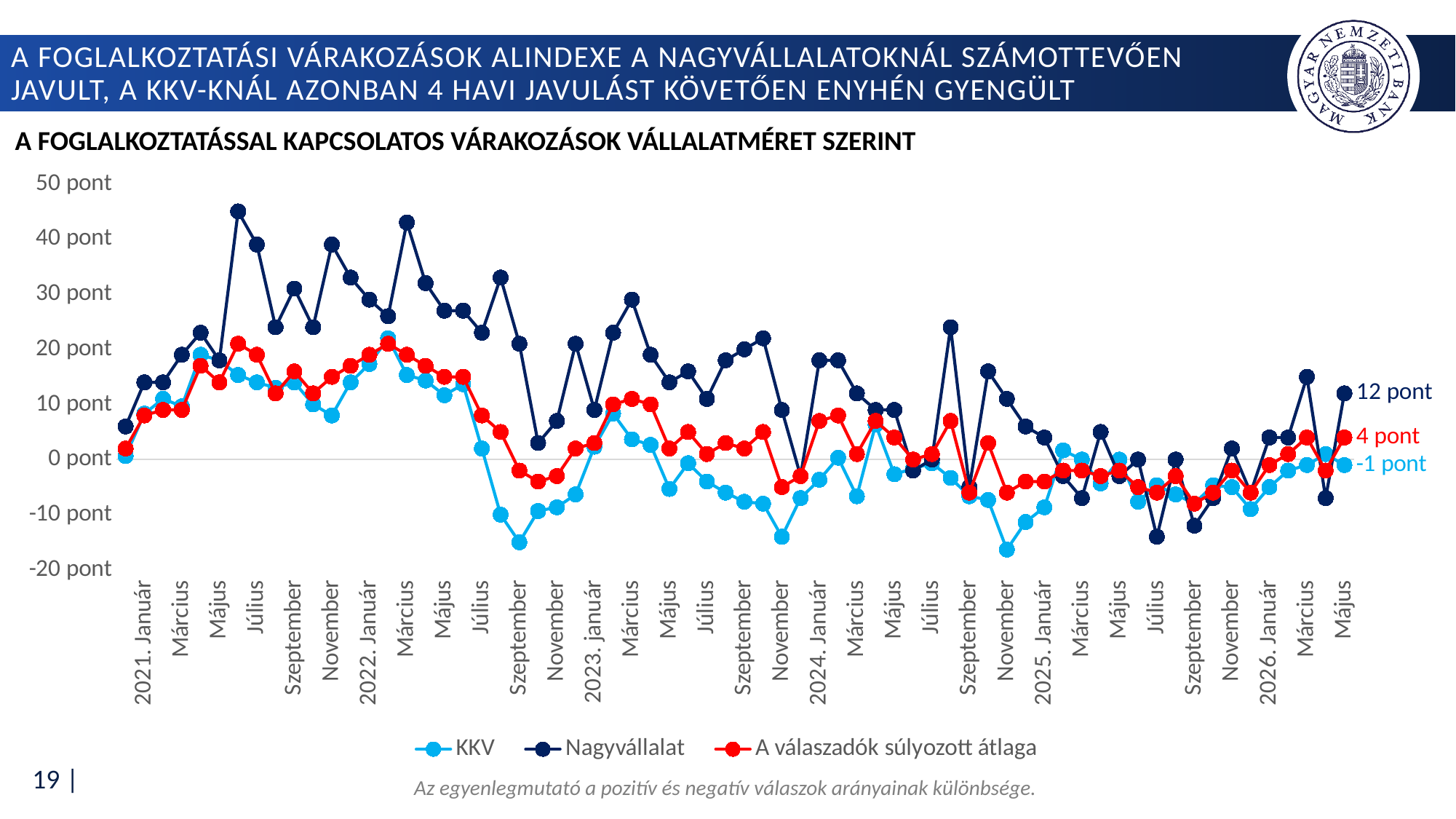
Which series reaches the highest value anywhere on the chart? Nagyvállalat What is the difference between the Nagyvállalat value and the weighted average value at the last point (2026 Május)? 8 pont At the last point (2026 Május), which is larger: the Nagyvállalat value or the KKV value? Nagyvállalat What kind of chart is shown on the slide? Line chart Which series has the lowest value at the last point (2026 Május)? KKV What is the value of the KKV series at the last point (2026 Május)? -1 pont Is the highest value of the Nagyvállalat series greater or less than 40 pont? greater Is the lowest value of the KKV series greater or less than -10 pont? less How many series does the legend list? 3 What is the value of the Nagyvállalat series at the last point (2026 Május)? 12 pont What is the value of 'A válaszadók súlyozott átlaga' at the last point (2026 Május)? 4 pont What is the difference between the Nagyvállalat and KKV values at the last point (2026 Május)? 13 pont